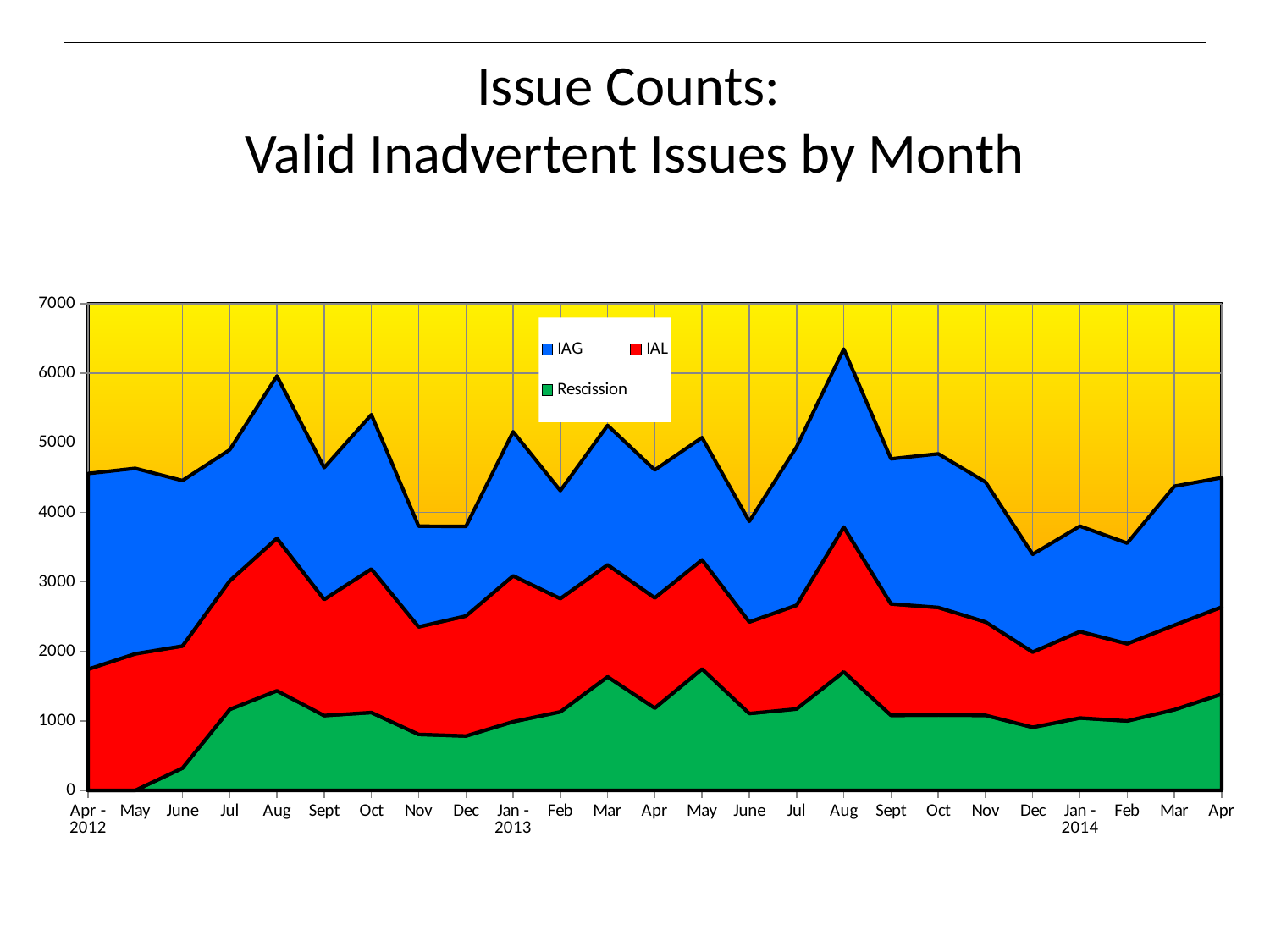
Which is larger, the Rescission value for Aug 2012 or for Nov 2012? Aug 2012 Which colour represents the IAL series? Red How many months are plotted along the x axis? 25 In which month is the total stacked value highest? Aug 2013 Is the total stacked value for Aug 2013 greater or less than 6000? greater Does the Rescission value rise or fall from Apr 2012 to Aug 2012? rise Is the Rescission value for Nov 2012 greater or less than 1000? less In which month is the total stacked value lowest? Dec 2013 What is the Rescission value for Apr 2012? 0 How many series does the legend list? 3 Is the total stacked value for Dec 2013 greater or less than 4000? less What kind of chart is shown on the slide? Area chart